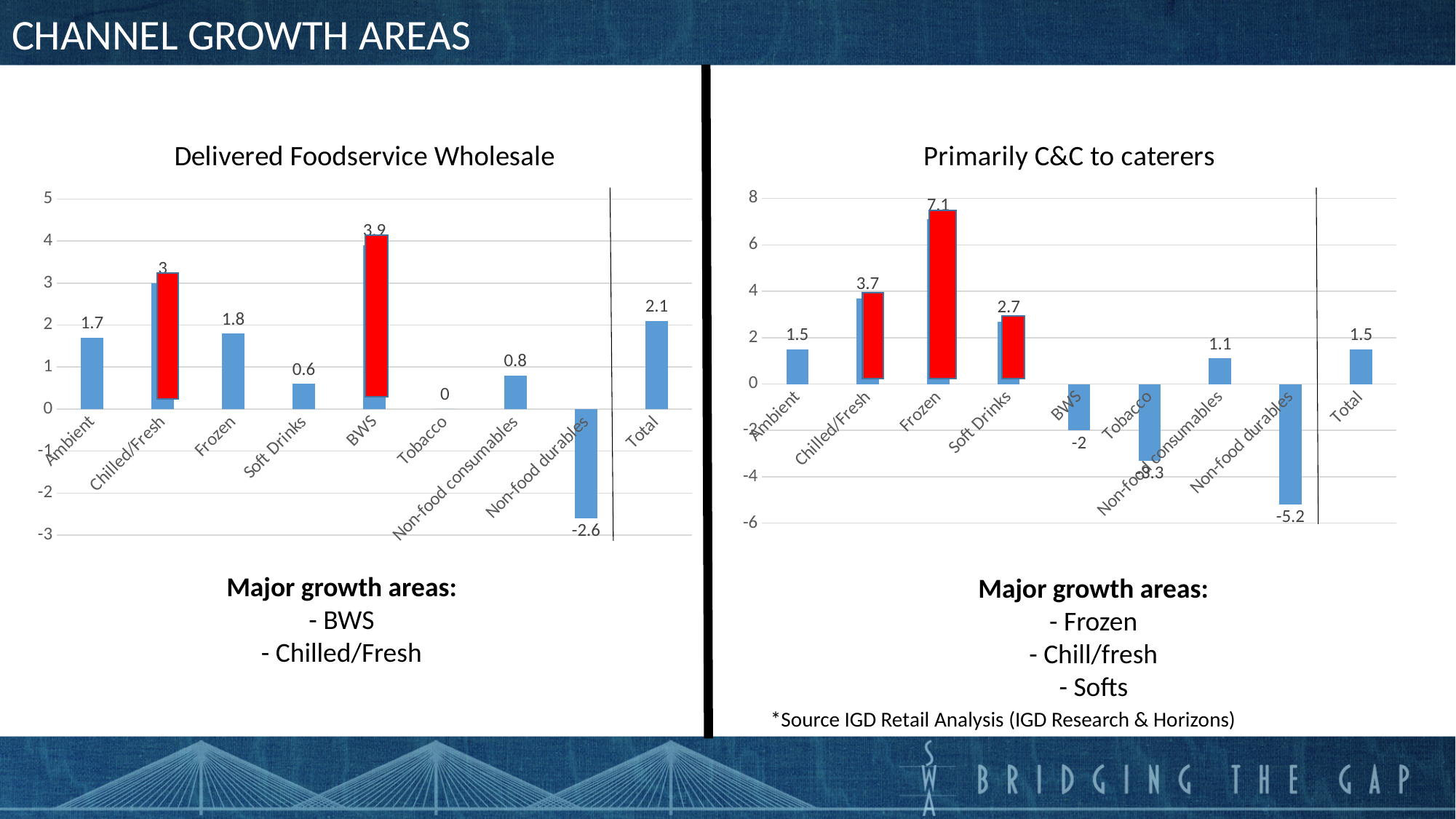
In the Delivered Foodservice Wholesale chart, what is the value for Tobacco? 0 In the Delivered Foodservice Wholesale chart, which category has the highest value? BWS In the Primarily C&C to caterers chart, what is the value for Frozen? 7.1 In the Delivered Foodservice Wholesale chart, which category has the lowest value? Non-food durables In the Delivered Foodservice Wholesale chart, what is the value for BWS? 3.9 How many categories are shown on the x axis of the Primarily C&C to caterers chart? 9 In the Delivered Foodservice Wholesale chart, what is the value for Non-food durables? -2.6 In the Primarily C&C to caterers chart, what is the difference between the values for Frozen and Chilled/Fresh? 3.4 In the Primarily C&C to caterers chart, which category has the lowest value? Non-food durables In the Delivered Foodservice Wholesale chart, what is the difference between the values for BWS and Chilled/Fresh? 0.9 What type of chart is the Delivered Foodservice Wholesale chart? Bar chart In the Primarily C&C to caterers chart, which is larger, the value for Chilled/Fresh or the value for Soft Drinks? Chilled/Fresh